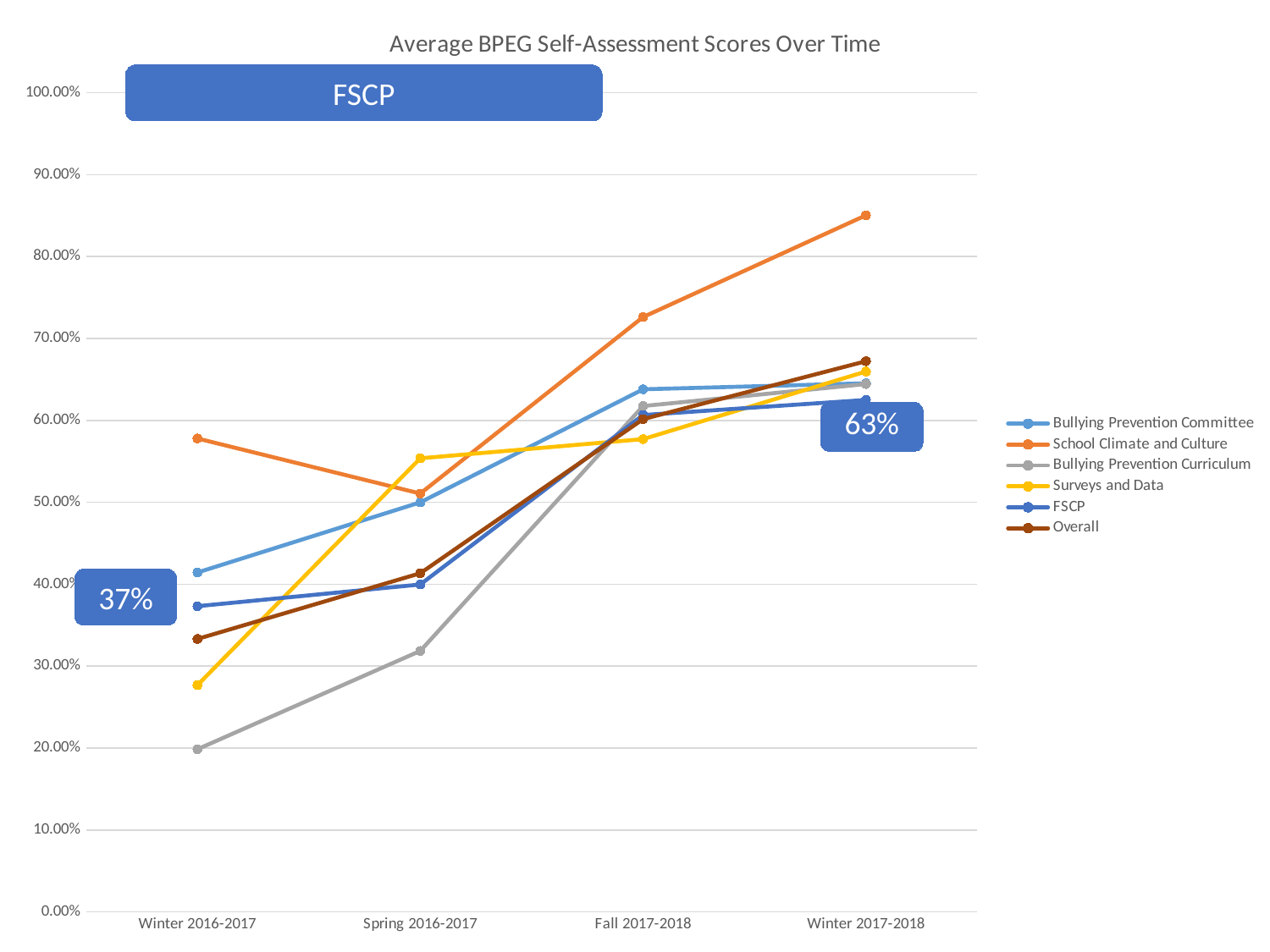
What is the title of the chart? Average BPEG Self-Assessment Scores Over Time How many series does the legend list? 6 Does the Bullying Prevention Curriculum series rise or fall from Winter 2016-2017 to Winter 2017-2018? rise What kind of chart is shown on the slide? line chart Is the value for School Climate and Culture at Winter 2017-2018 greater or less than 80.00%? greater Is the value for Bullying Prevention Curriculum at Winter 2016-2017 greater or less than 30.00%? less Which series has the lowest value at Winter 2016-2017? Bullying Prevention Curriculum Is the value for Surveys and Data at Winter 2016-2017 greater or less than 30.00%? less At Spring 2016-2017, which is larger: Surveys and Data or Bullying Prevention Committee? Surveys and Data Does the School Climate and Culture series rise or fall from Winter 2016-2017 to Spring 2016-2017? fall Which series has the highest value at Winter 2017-2018? School Climate and Culture How many time points are shown along the x axis? 4